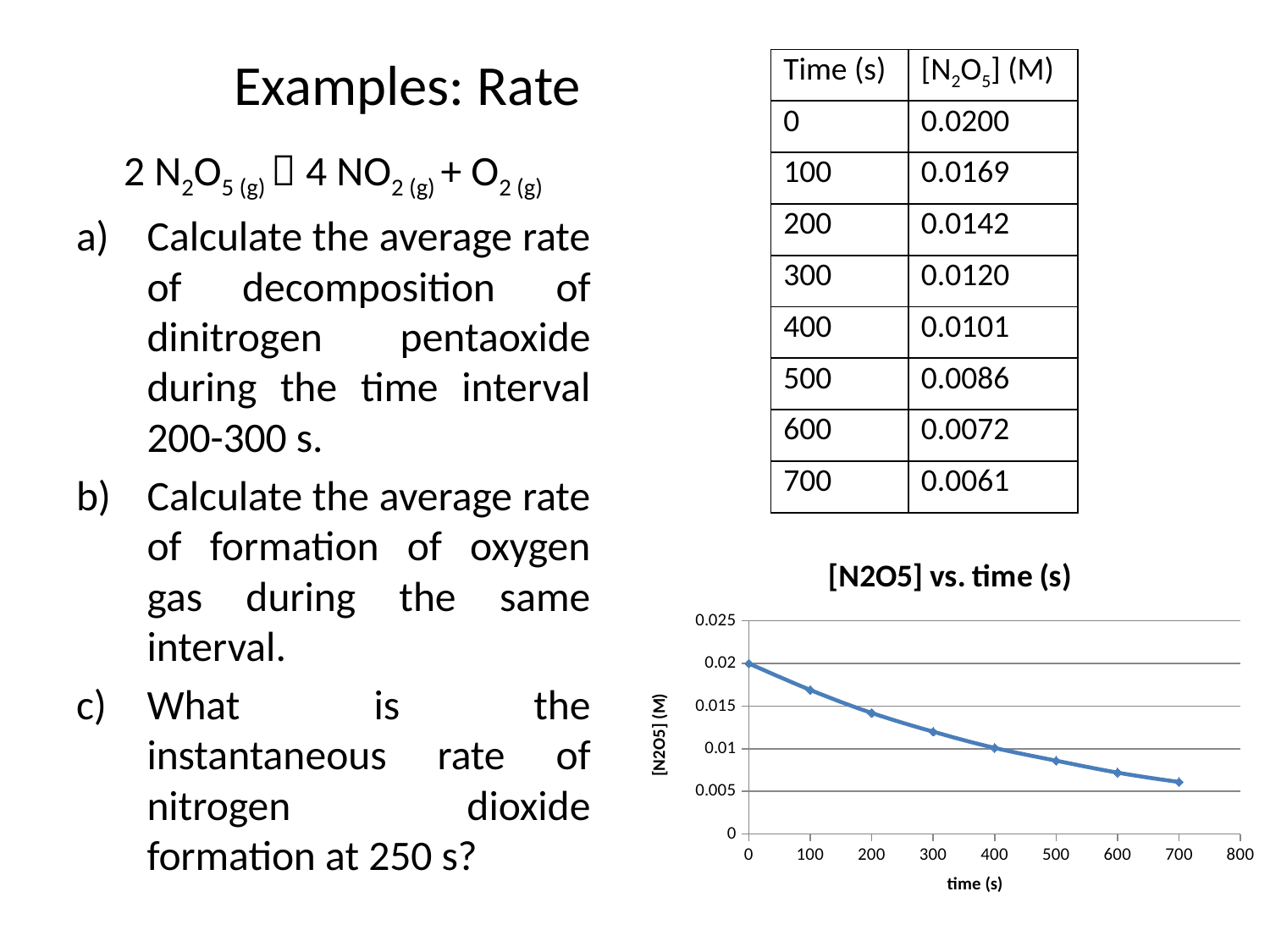
Is the plotted value at 500 s greater or less than 0.01? less What is the [N2O5] value at time 0 s? 0.0200 What is the [N2O5] value at time 300 s? 0.0120 Do the plotted values rise or fall as time increases along the x axis? fall At which time (s) is the plotted [N2O5] value lowest? 700 How many data points are plotted on the chart? 8 At which time (s) is the plotted [N2O5] value highest? 0 What kind of chart is shown on the slide? line chart Is the plotted value at 100 s greater or less than 0.015? greater What is the label of the x axis of the chart? time (s) What is the title of the chart? [N2O5] vs. time (s) Which is larger, the [N2O5] value at 200 s or at 600 s? 200 s